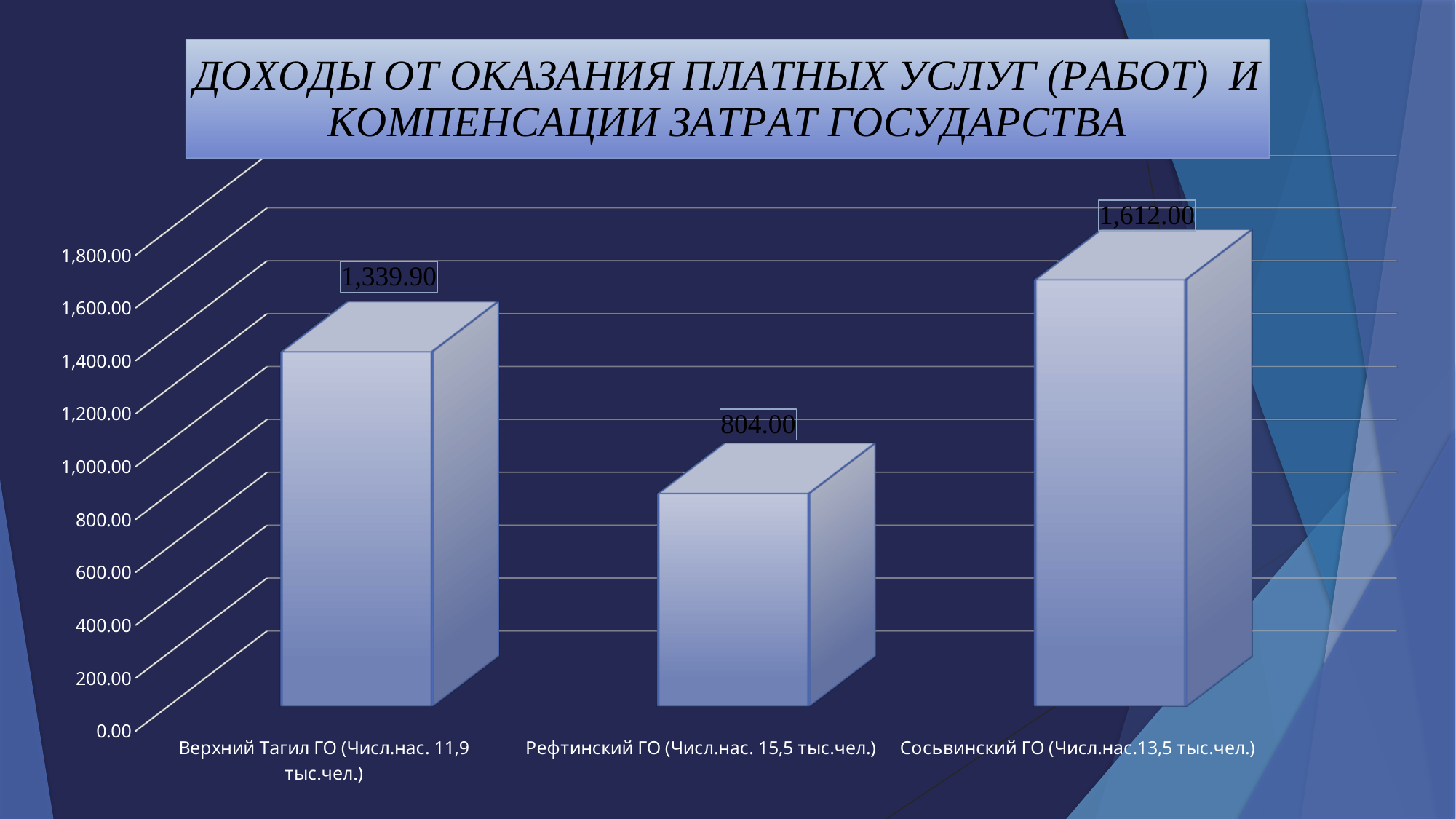
What is the value for Верхний Тагил ГО? 1,339.90 Is the value for Рефтинский ГО greater or less than 1,000.00? less Which is larger, the value for Верхний Тагил ГО or the value for Рефтинский ГО? Верхний Тагил ГО Which category has the lowest value? Рефтинский ГО Which category has the highest value? Сосьвинский ГО What kind of chart is shown on the slide? bar chart What is the value for Сосьвинский ГО? 1,612.00 How many categories are shown on the chart? 3 What is the difference between the values for Верхний Тагил ГО and Рефтинский ГО? 535.90 What is the difference between the values for Сосьвинский ГО and Верхний Тагил ГО? 272.10 What is the title of the chart? ДОХОДЫ ОТ ОКАЗАНИЯ ПЛАТНЫХ УСЛУГ (РАБОТ) И КОМПЕНСАЦИИ ЗАТРАТ ГОСУДАРСТВА What is the value for Рефтинский ГО? 804.00